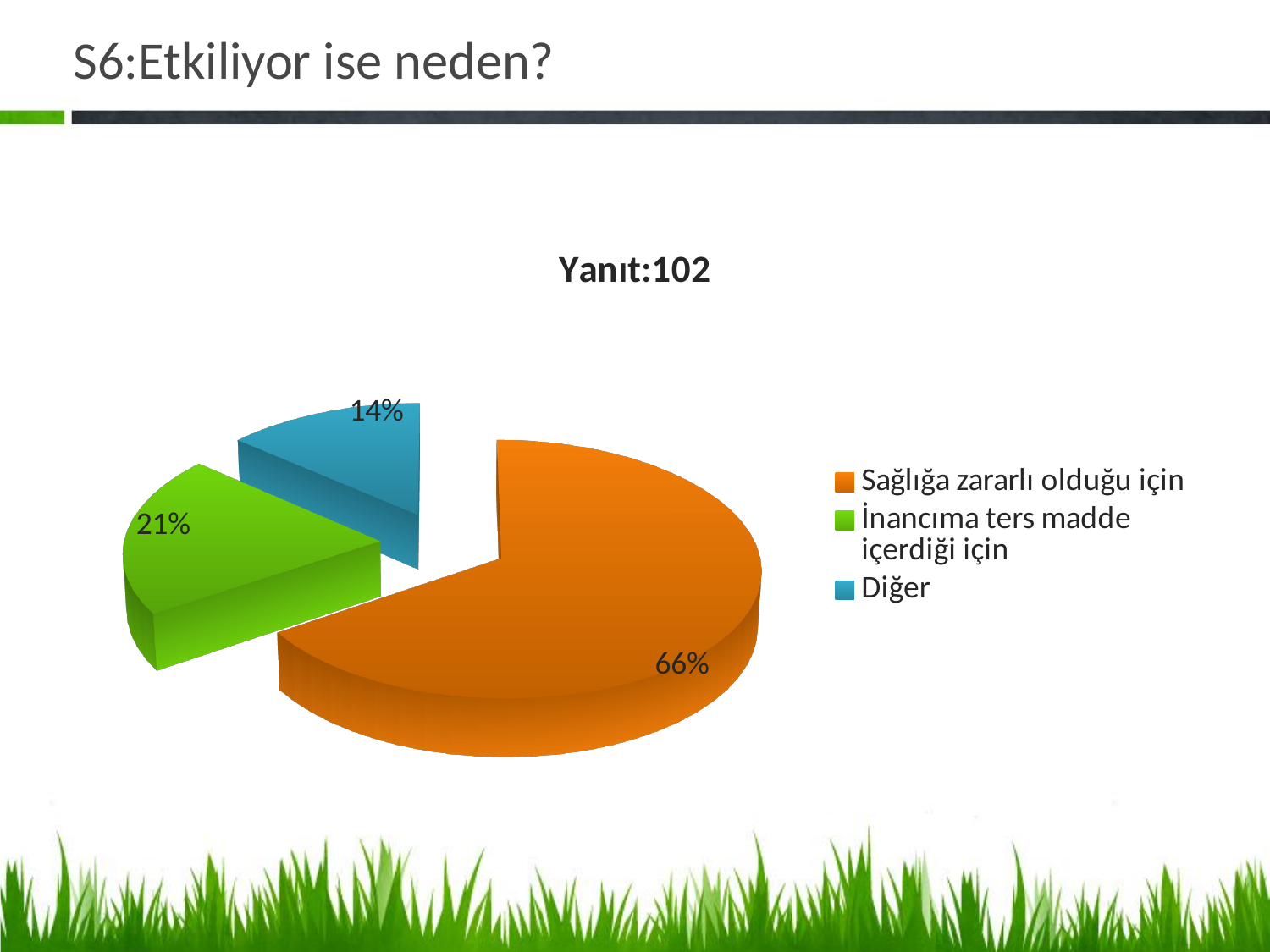
What percentage is shown for "İnancıma ters madde içerdiği için"? 21% Which category has the largest share of the pie? Sağlığa zararlı olduğu için What kind of chart is shown on the slide? pie chart How many entries does the legend list? 3 What is the difference in percentage points between "Sağlığa zararlı olduğu için" and "İnancıma ters madde içerdiği için"? 45 What percentage is shown for "Diğer"? 14% Which category has the smallest share of the pie? Diğer What percentage is shown for "Sağlığa zararlı olduğu için"? 66% Which is larger, the share for "İnancıma ters madde içerdiği için" or the share for "Diğer"? İnancıma ters madde içerdiği için What is the title of the chart? Yanıt:102 What colour is the slice for "Diğer"? blue How many slices does the pie chart have? 3